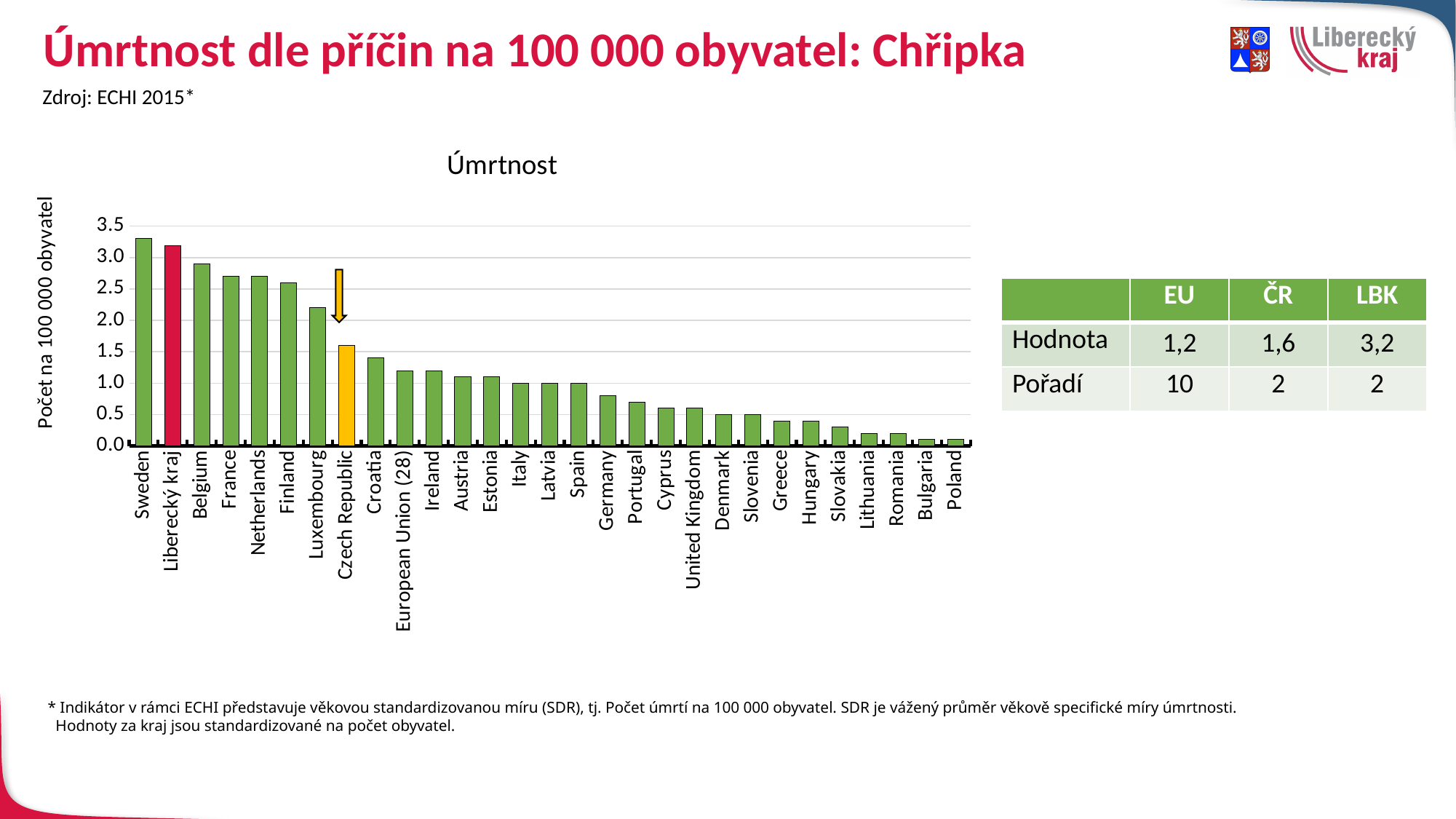
How many countries/regions are shown as bars in the chart? 29 Which bar in the chart is the highest? Sweden Is the value for Sweden greater or less than 3.0? greater What colour is the bar for Liberecký kraj? red Is the value for Luxembourg greater or less than 2.0? greater Is the value for Poland greater or less than 0.5? less What kind of chart is shown on the slide? bar chart Which has a higher value, Belgium or Croatia? Belgium Do the bar values rise or fall from left to right along the x axis? fall What is the title of the chart? Úmrtnost